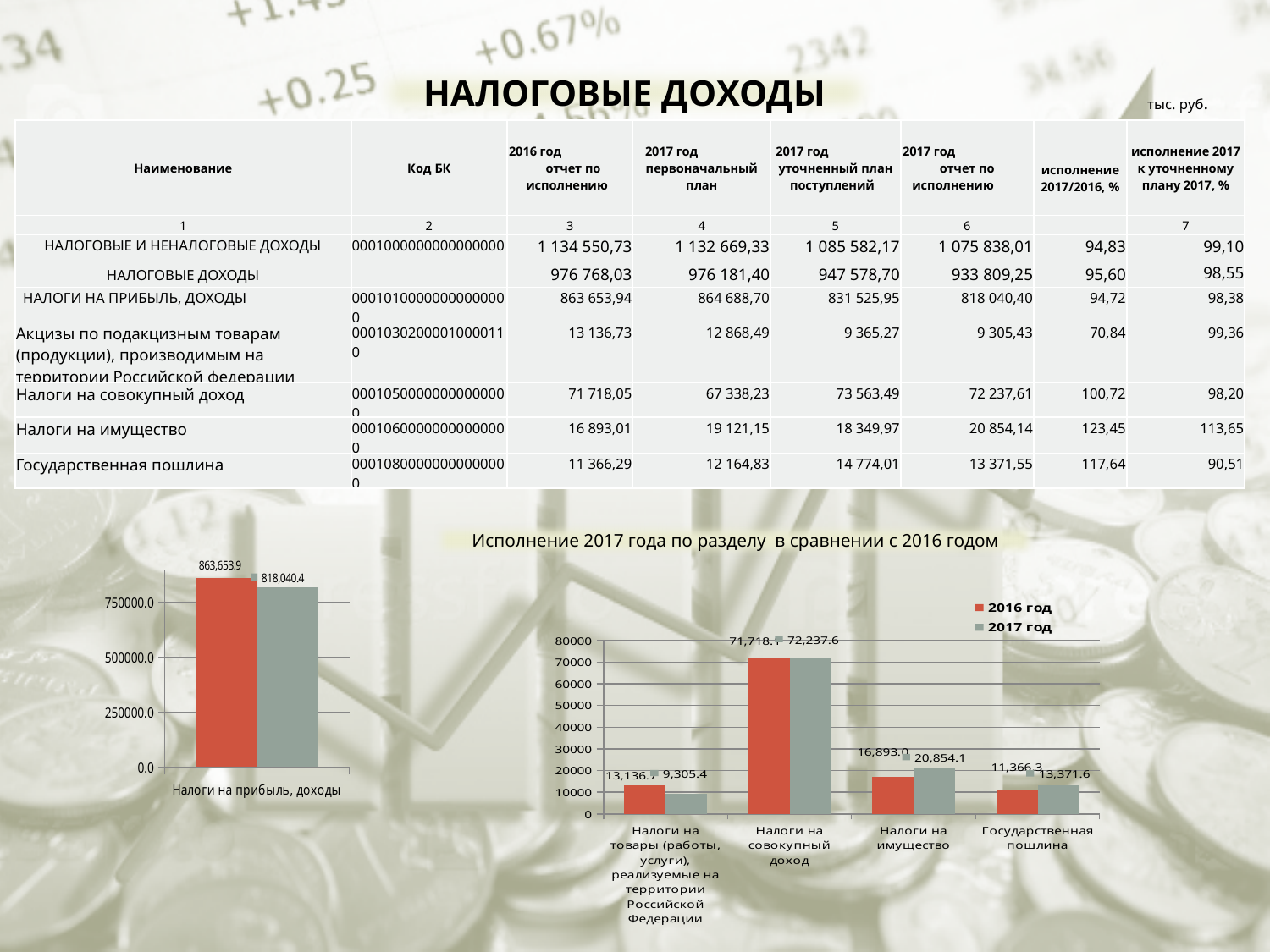
On the chart titled 'Исполнение 2017 года по разделу в сравнении с 2016 годом', which is larger for Государственная пошлина: the 2016 год value or the 2017 год value? 2017 год On the chart titled 'Исполнение 2017 года по разделу в сравнении с 2016 годом', which category has the highest 2017 год value? Налоги на совокупный доход On the chart titled 'Исполнение 2017 года по разделу в сравнении с 2016 годом', what is the 2016 год value for Государственная пошлина? 11,366.3 On the chart titled 'Исполнение 2017 года по разделу в сравнении с 2016 годом', what is the 2017 год value for Налоги на имущество? 20,854.1 On the chart titled 'Исполнение 2017 года по разделу в сравнении с 2016 годом', which category has the lowest 2017 год value? Налоги на товары (работы, услуги), реализуемые на территории Российской Федерации What kind of chart is the chart on the bottom left of the slide? Bar chart On the bottom-left chart, what is the value of the taller bar for Налоги на прибыль, доходы? 863,653.9 How many categories are shown on the chart titled 'Исполнение 2017 года по разделу в сравнении с 2016 годом'? 4 On the chart titled 'Исполнение 2017 года по разделу в сравнении с 2016 годом', what is the difference between the 2017 год and 2016 год values for Налоги на имущество? 3,961.1 On the chart titled 'Исполнение 2017 года по разделу в сравнении с 2016 годом', is the 2016 год value for Налоги на совокупный доход greater or less than 60000? greater How many series does the legend list on the chart titled 'Исполнение 2017 года по разделу в сравнении с 2016 годом'? 2 On the chart titled 'Исполнение 2017 года по разделу в сравнении с 2016 годом', what is the 2017 год value for Налоги на совокупный доход? 72,237.6